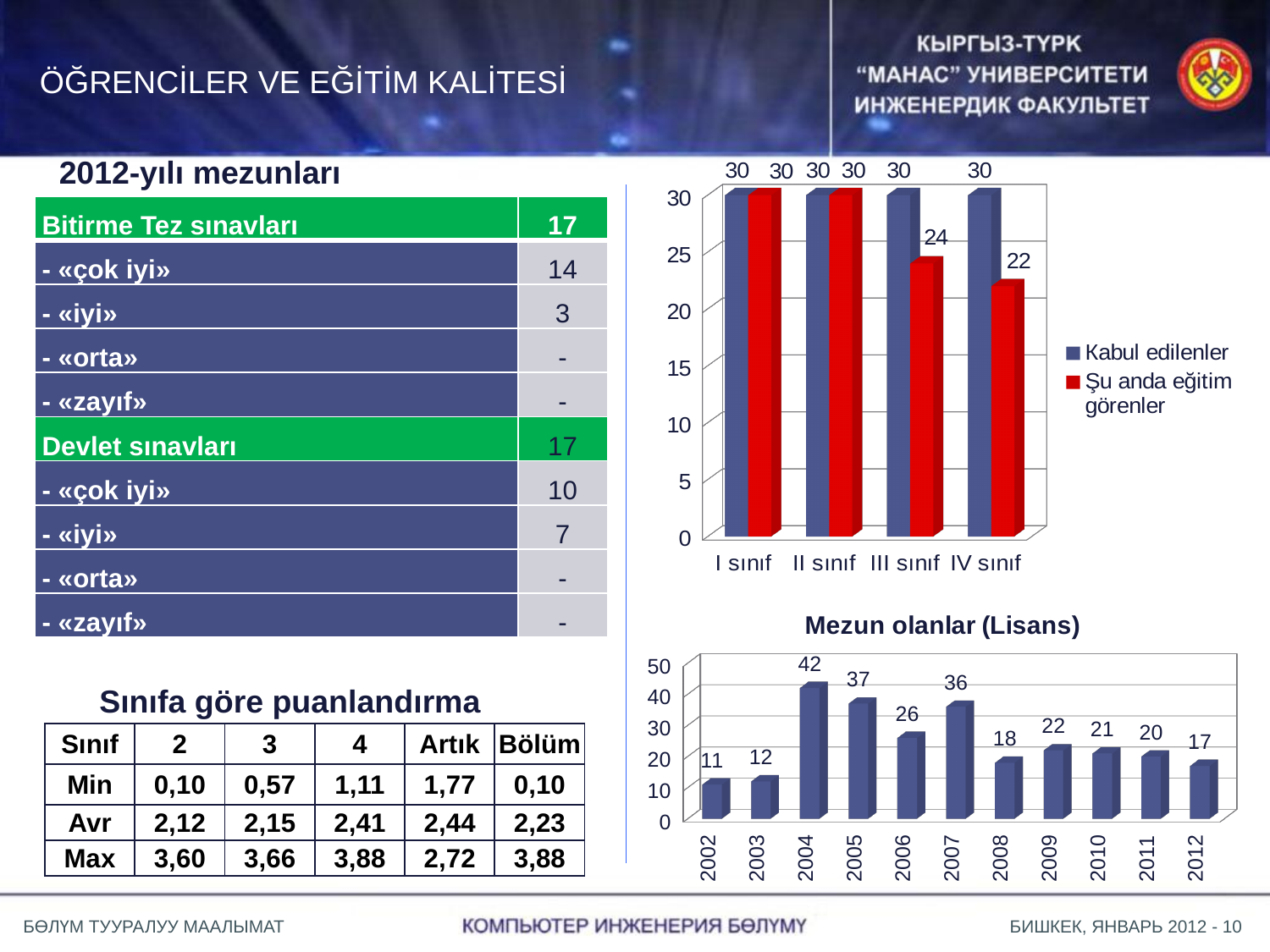
In the top-right chart, what is the 'Şu anda eğitim görenler' value for III sınıf? 24 In the top-right chart, what is the difference between 'Kabul edilenler' and 'Şu anda eğitim görenler' for IV sınıf? 8 In the 'Mezun olanlar (Lisans)' chart, which year has the lowest value? 2002 In the 'Mezun olanlar (Lisans)' chart, what is the value for 2004? 42 How many series does the legend of the top-right chart list? 2 In the 'Mezun olanlar (Lisans)' chart, how many years are shown on the x axis? 11 In the 'Mezun olanlar (Lisans)' chart, what is the value for 2012? 17 In the 'Mezun olanlar (Lisans)' chart, which is larger, the value for 2009 or the value for 2011? 2009 In the 'Mezun olanlar (Lisans)' chart, which year has the highest value? 2004 In the top-right chart, what is the 'Kabul edilenler' value for IV sınıf? 30 In the 'Mezun olanlar (Lisans)' chart, what is the difference between the values for 2005 and 2006? 11 What kind of chart is the 'Mezun olanlar (Lisans)' chart? Bar chart